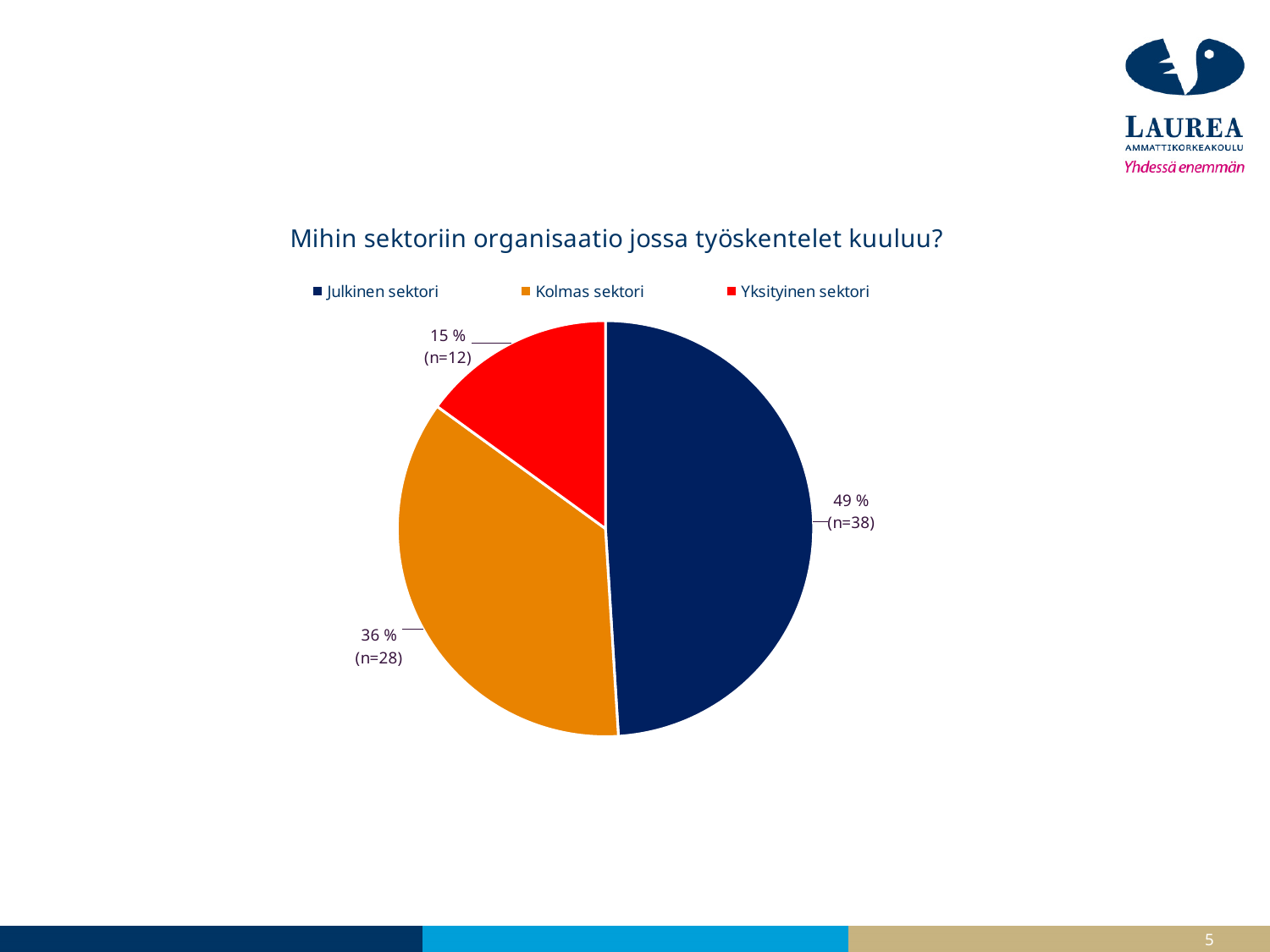
What percentage share does Julkinen sektori have? 49 % What is the n value shown for Julkinen sektori? n=38 What is the chart's title? Mihin sektoriin organisaatio jossa työskentelet kuuluu? How many entries does the legend list? 3 What kind of chart is shown on the slide? pie chart What is the n value shown for Yksityinen sektori? n=12 What is the difference in percentage points between Julkinen sektori and Kolmas sektori? 13 % Which sector has the largest slice? Julkinen sektori What percentage share does Kolmas sektori have? 36 % What percentage share does Yksityinen sektori have? 15 % Which sector has the smallest slice? Yksityinen sektori How many slices does the pie chart have? 3